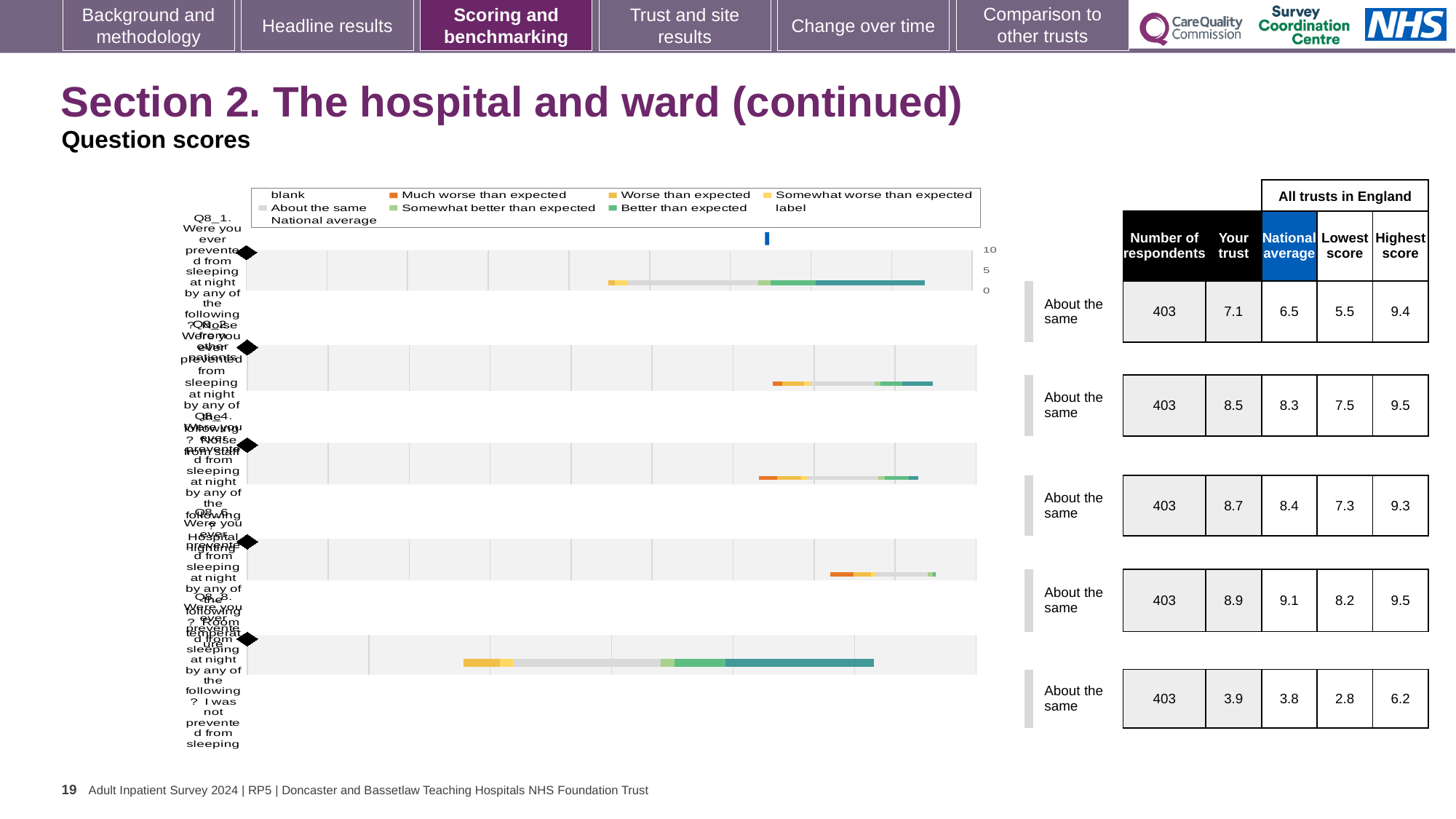
In the table next to the chart, what is the 'Your trust' score for the first (top) question row? 7.1 What colour represents 'Much worse than expected' in the chart legend? orange What is the highest score across all trusts in England for the third question row? 9.3 How many respondents are listed for each question row in the table? 403 What benchmark category is shown for every question row on the slide? About the same Which question row has the highest 'Your trust' score? the fourth row (8.9) How many question rows (bars) are plotted on the slide? 5 In the table next to the chart, what is the national average for the bottom question row? 3.8 For the top question row, what is the difference between the 'Your trust' score and the national average? 0.6 For the fourth question row, which is larger: the 'Your trust' score or the national average? National average What kind of chart is used to show the question scores on this slide? bar chart Which question row has the lowest 'Your trust' score? the bottom row (3.9)